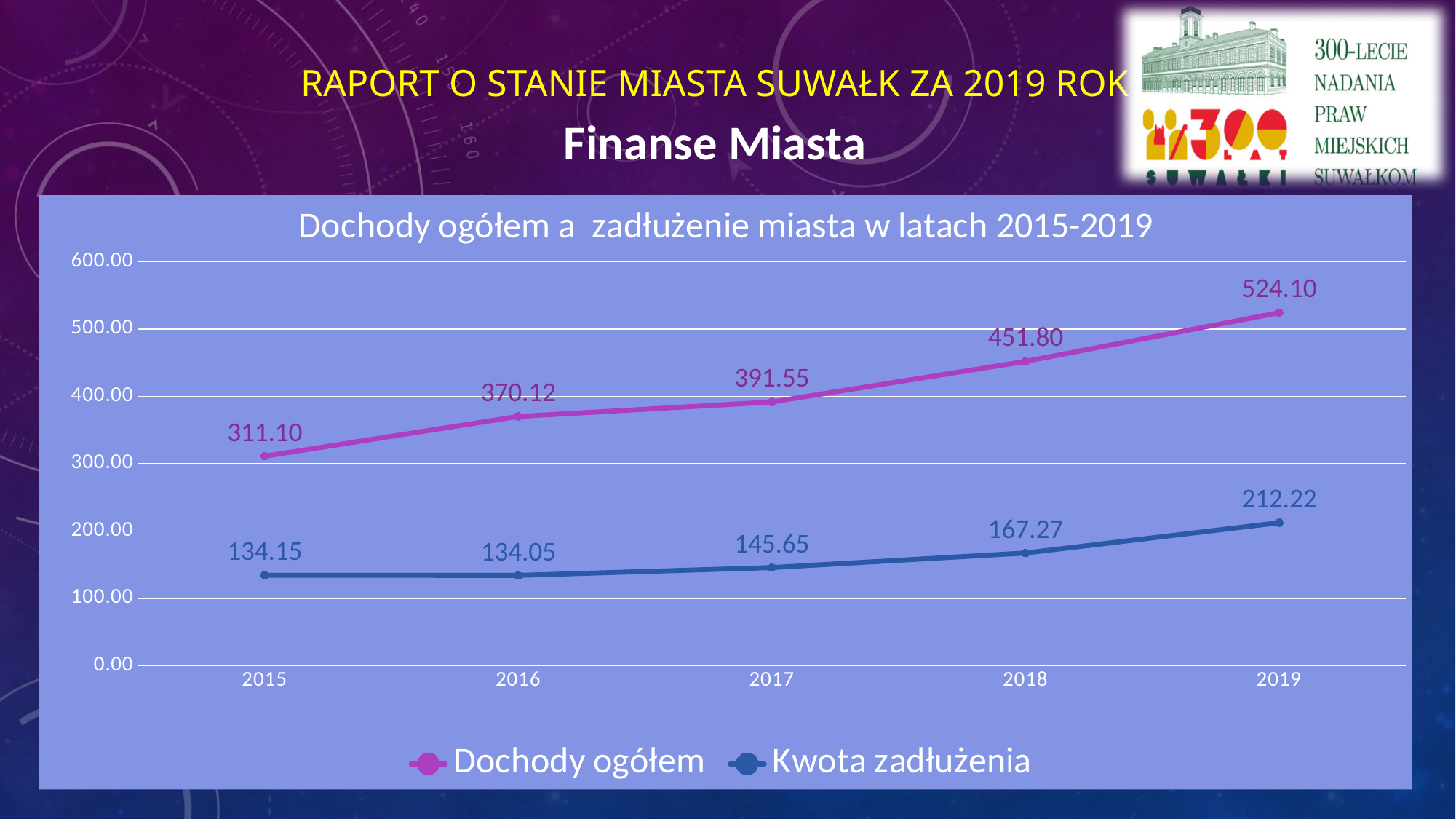
What kind of chart is shown on the slide? line chart Is the value of Kwota zadłużenia in 2019 greater or less than 200.00? greater How many series does the legend list? 2 What is the value of Dochody ogółem in 2019? 524.10 In which year is Kwota zadłużenia highest? 2019 Which is larger in 2018: Dochody ogółem or Kwota zadłużenia? Dochody ogółem In which year is Dochody ogółem lowest? 2015 How many years are shown on the x axis? 5 What is the value of Kwota zadłużenia in 2017? 145.65 What is the difference between Dochody ogółem and Kwota zadłużenia in 2019? 311.88 What is the value of Dochody ogółem in 2015? 311.10 By how much did Dochody ogółem increase from 2017 to 2018? 60.25